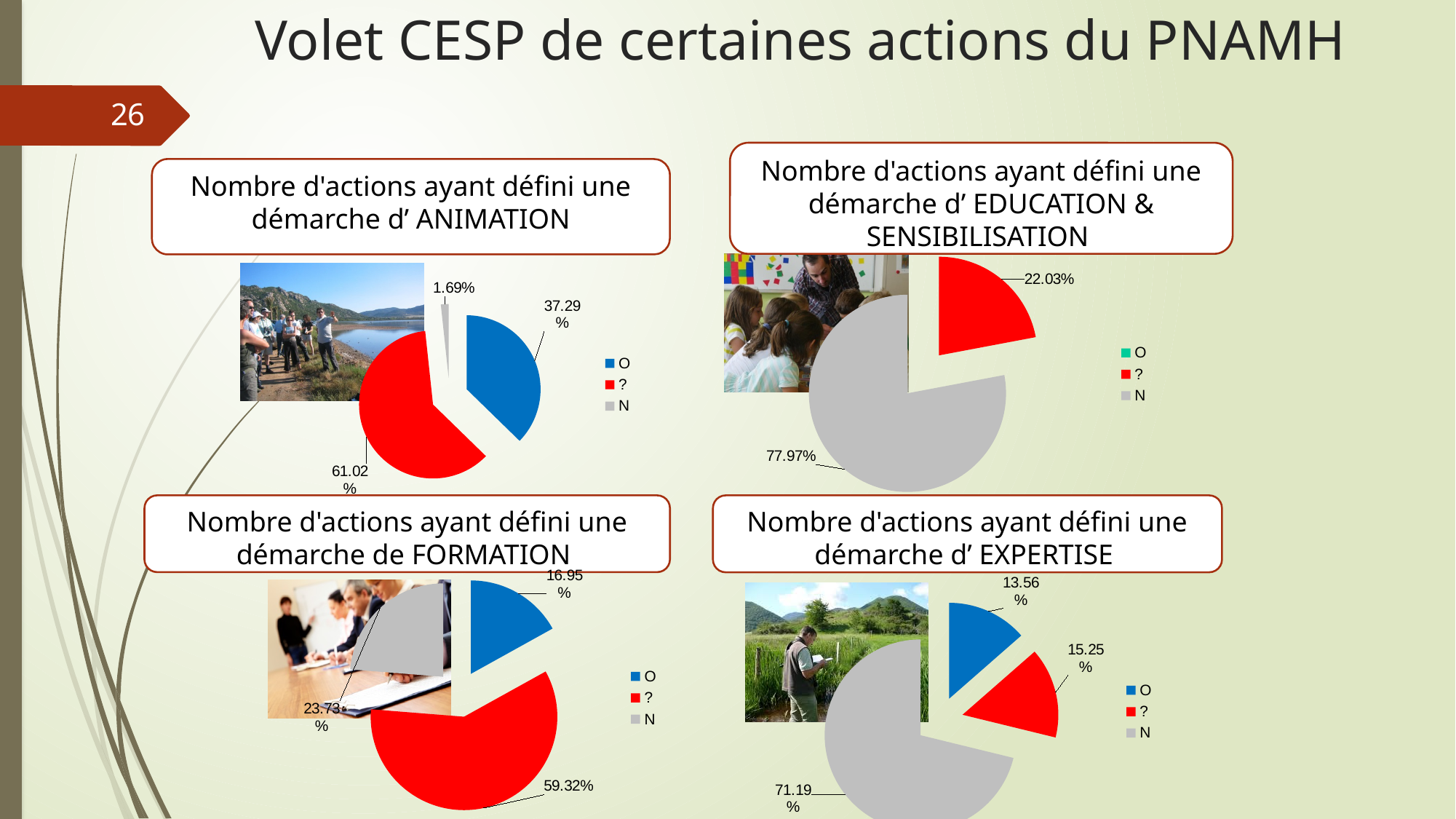
In the EDUCATION & SENSIBILISATION chart, what is the value for 'N'? 77.97% In the FORMATION chart, what is the value for 'O'? 16.95% In the FORMATION chart, which is larger, the 'N' slice or the 'O' slice? N In the EXPERTISE chart, what is the difference between the '?' and 'O' slices? 1.69% In the ANIMATION chart, which category has the largest slice? ? In the ANIMATION chart, what is the value for the 'N' slice? 1.69% In the EDUCATION & SENSIBILISATION chart, what is the difference between the 'N' and '?' slices? 55.94% How many series does the legend of the EXPERTISE chart list? 3 In the EXPERTISE chart, what is the value for 'N'? 71.19% In the FORMATION chart, which category has the smallest slice? O What type of chart is used for the ANIMATION data? Pie chart In the ANIMATION chart, what share of actions is labelled '?'? 61.02%